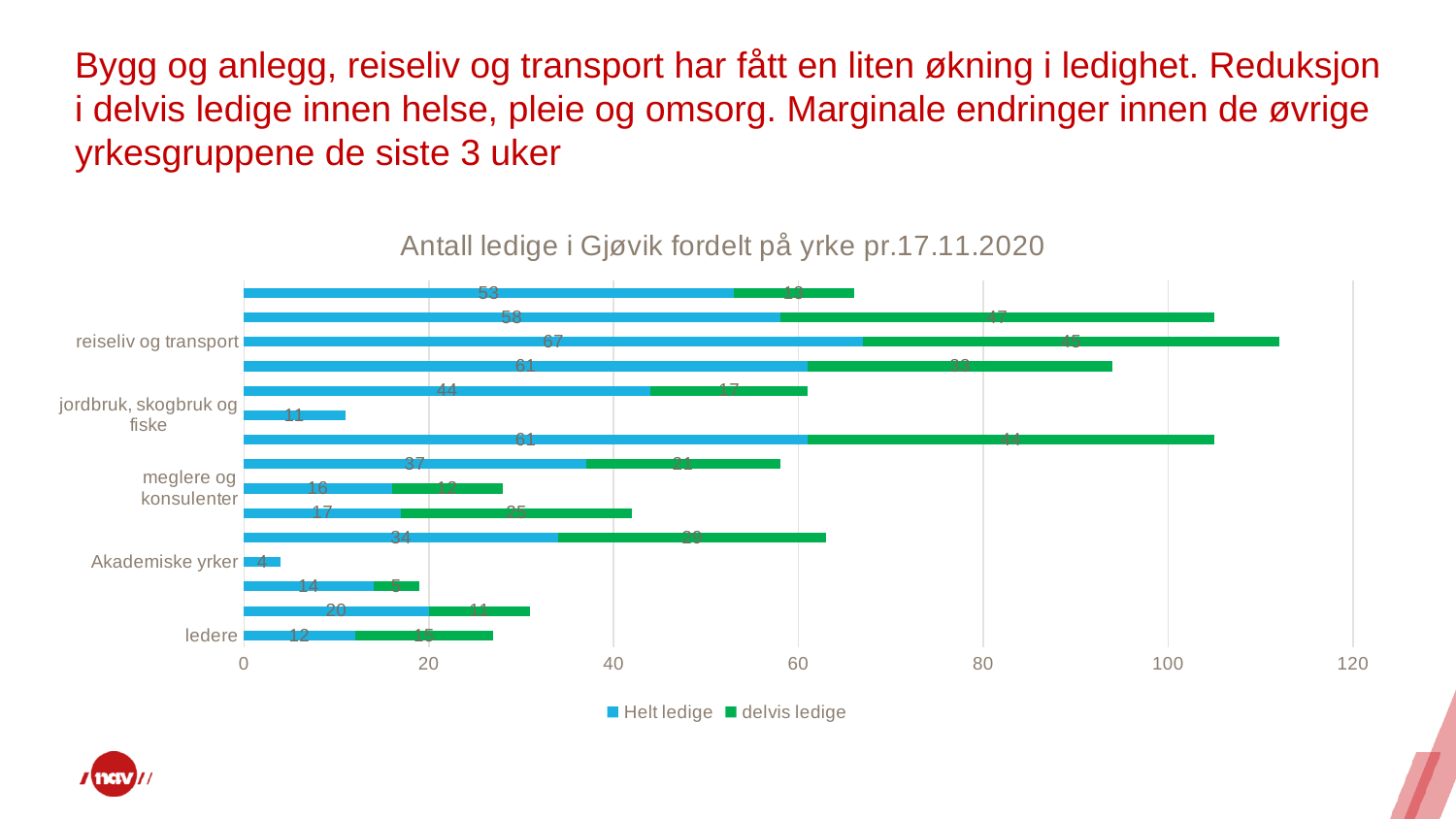
What type of chart is shown on the slide? bar chart Is the total length of the stacked bar for reiseliv og transport greater or less than 100? greater What is the title of the chart? Antall ledige i Gjøvik fordelt på yrke pr.17.11.2020 Among the labelled categories, which has the highest Helt ledige value? reiseliv og transport What is the Helt ledige value for ledere? 12 What is the Helt ledige value for reiseliv og transport? 67 What is the Helt ledige value for Akademiske yrker? 4 How many series does the legend list? 2 What are the two series named in the legend? Helt ledige and delvis ledige What is the difference between the Helt ledige values for reiseliv og transport and ledere? 55 What is the Helt ledige value for jordbruk, skogbruk og fiske? 11 Among the labelled categories, which has the lowest Helt ledige value? Akademiske yrker